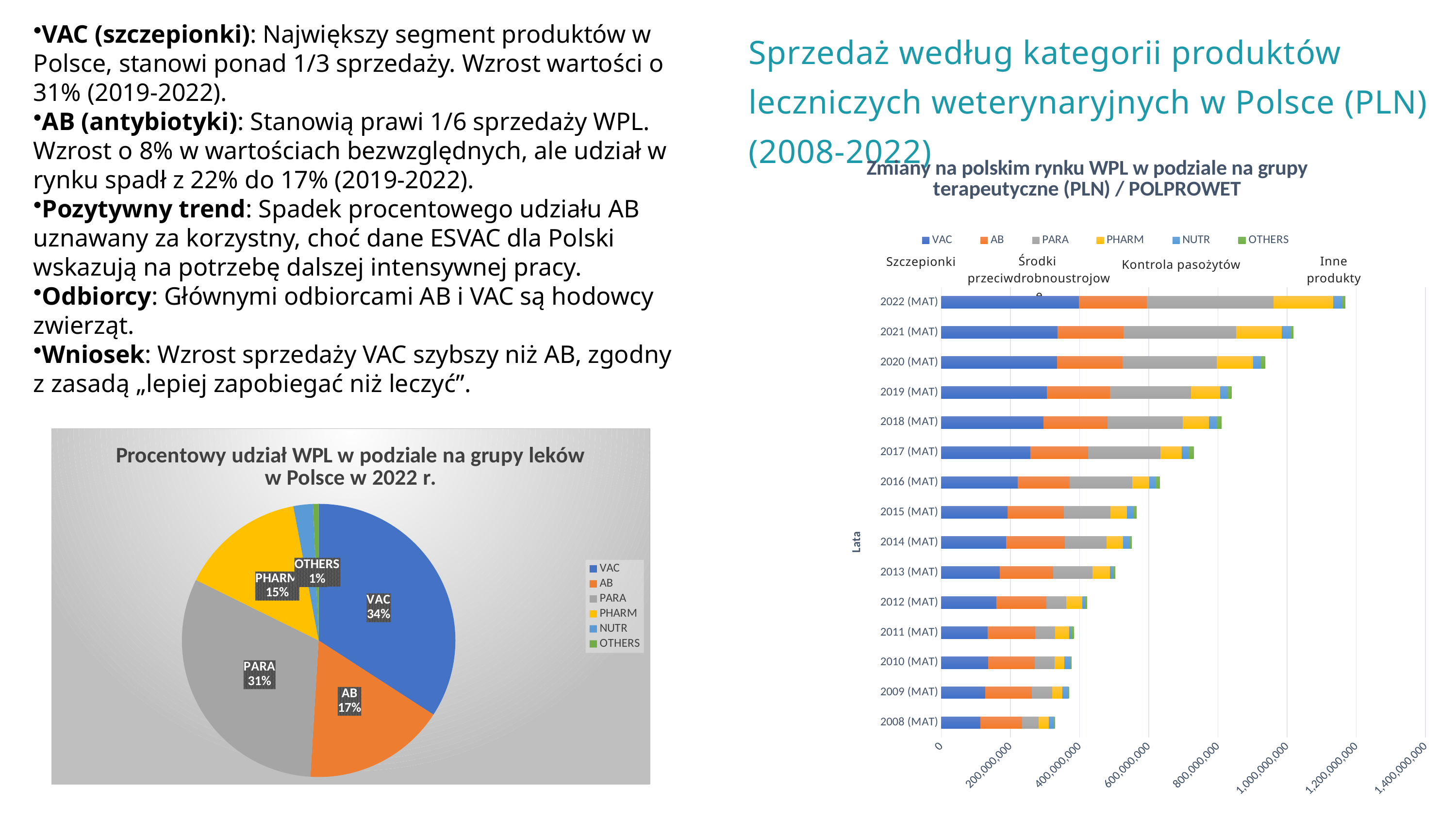
In the bar chart 'Zmiany na polskim rynku WPL w podziale na grupy terapeutyczne (PLN) / POLPROWET', which year has the longest total bar? 2022 (MAT) How many years (categories) are shown in the bar chart 'Zmiany na polskim rynku WPL w podziale na grupy terapeutyczne (PLN) / POLPROWET'? 15 What type of chart is 'Zmiany na polskim rynku WPL w podziale na grupy terapeutyczne (PLN) / POLPROWET'? Stacked bar chart In the bar chart 'Zmiany na polskim rynku WPL w podziale na grupy terapeutyczne (PLN) / POLPROWET', is the total bar for 2022 (MAT) greater or less than 1,000,000,000? greater In the pie chart 'Procentowy udział WPL w podziale na grupy leków w Polsce w 2022 r.', what is the difference in percentage points between VAC and AB? 17 In the pie chart 'Procentowy udział WPL w podziale na grupy leków w Polsce w 2022 r.', what share does VAC have? 34% In the pie chart 'Procentowy udział WPL w podziale na grupy leków w Polsce w 2022 r.', which labelled group has the smallest share? OTHERS How many entries does the legend of the pie chart 'Procentowy udział WPL w podziale na grupy leków w Polsce w 2022 r.' list? 6 In the pie chart 'Procentowy udział WPL w podziale na grupy leków w Polsce w 2022 r.', what share does AB have? 17% In the pie chart 'Procentowy udział WPL w podziale na grupy leków w Polsce w 2022 r.', which group has the largest share? VAC In the pie chart 'Procentowy udział WPL w podziale na grupy leków w Polsce w 2022 r.', which is larger, PARA or PHARM? PARA In the pie chart 'Procentowy udział WPL w podziale na grupy leków w Polsce w 2022 r.', what share does PARA have? 31%